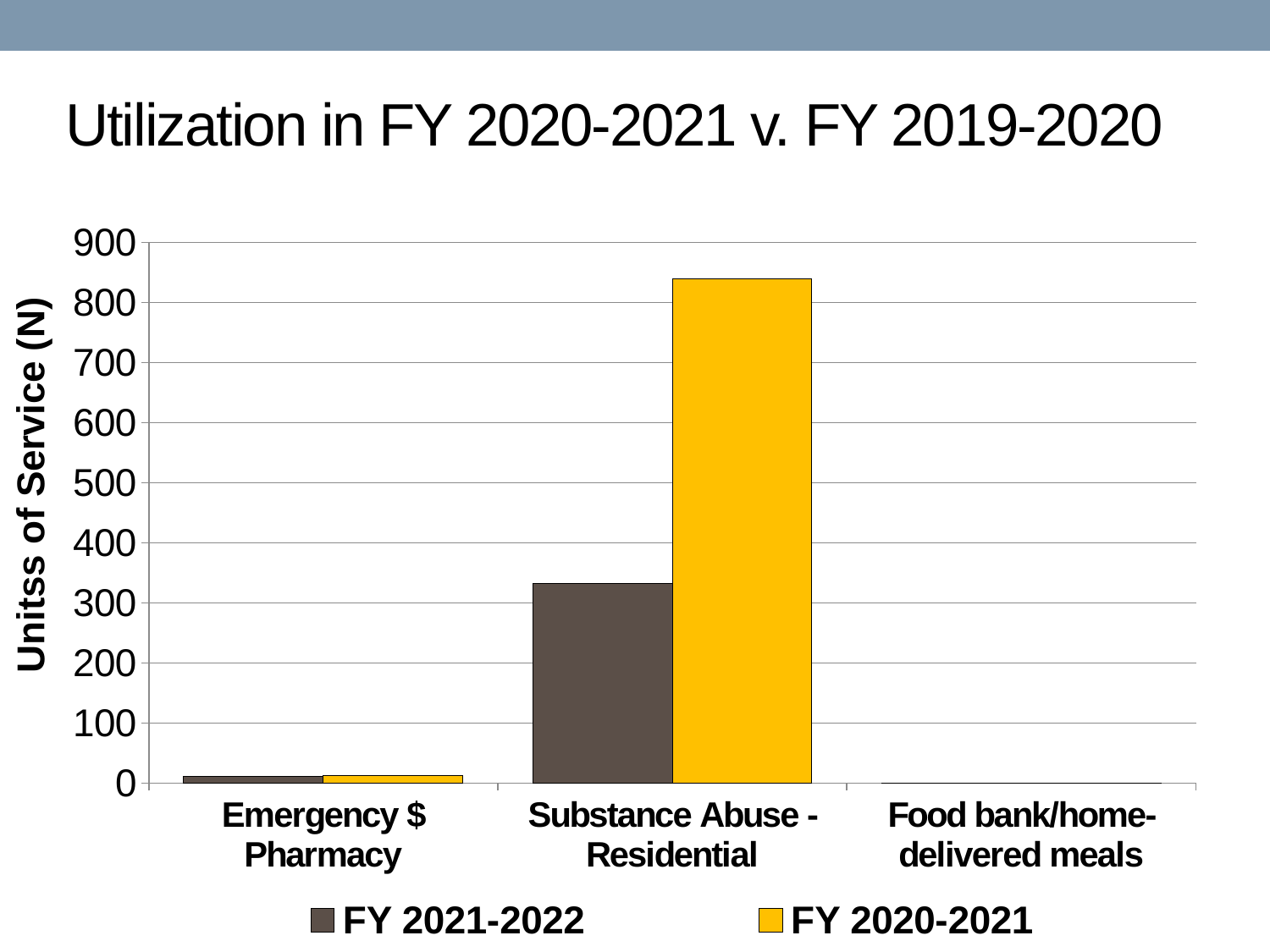
Is the FY 2020-2021 value for Emergency $ Pharmacy greater or less than 100? less What is the title of the chart? Utilization in FY 2020-2021 v. FY 2019-2020 Is the FY 2020-2021 value for Substance Abuse - Residential greater or less than 800? greater What is the label of the y axis? Unitss of Service (N) Which category has the highest value for FY 2020-2021? Substance Abuse - Residential Is the FY 2021-2022 value for Substance Abuse - Residential greater or less than 300? greater How many series does the legend list? 2 What kind of chart is shown on the slide? bar chart How many categories are shown on the x axis? 3 Which category has the highest value for FY 2021-2022? Substance Abuse - Residential For Substance Abuse - Residential, which series has the larger value, FY 2021-2022 or FY 2020-2021? FY 2020-2021